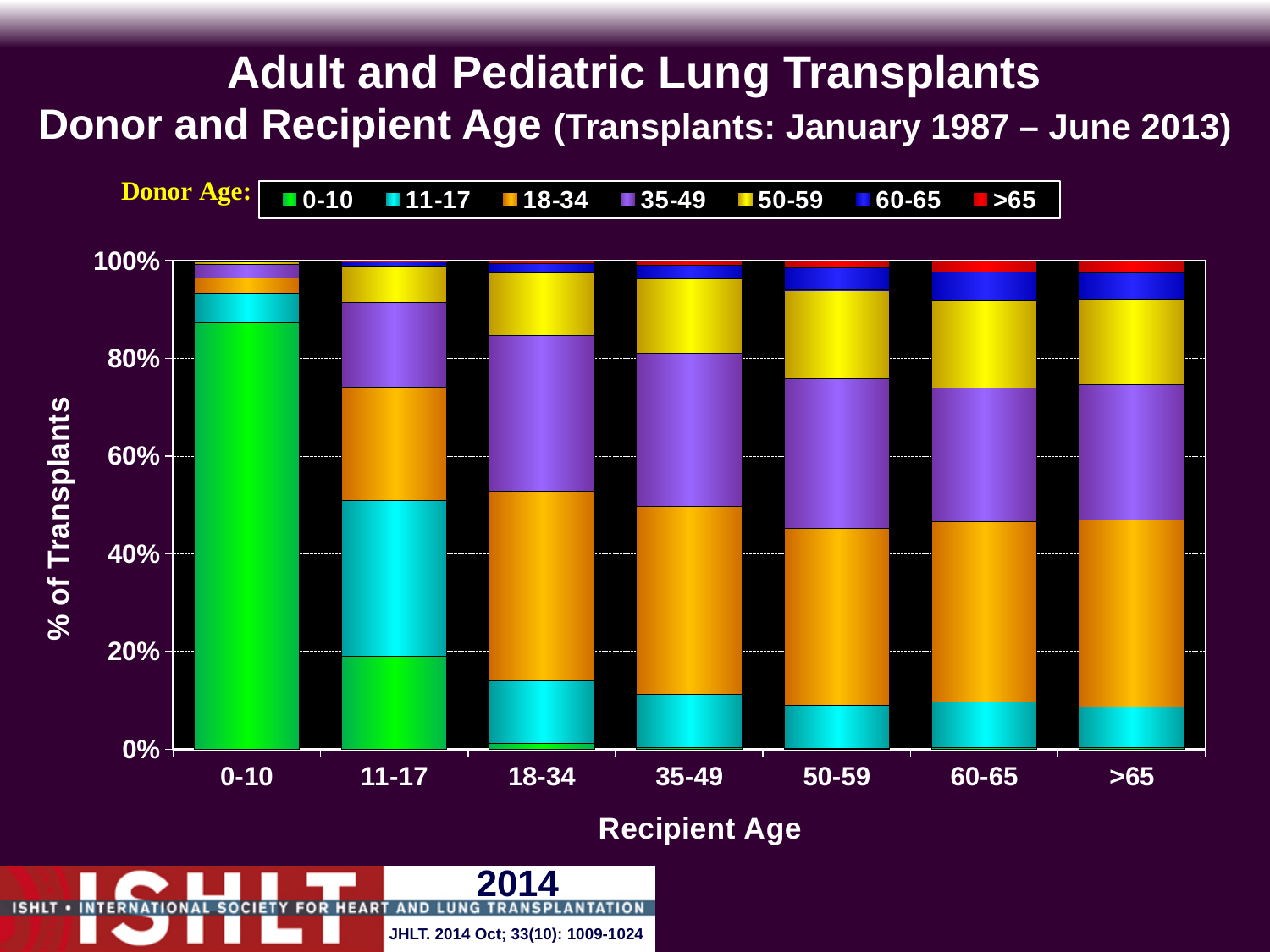
How many recipient age categories are shown on the x axis? 7 Which recipient age group has the largest share of 11-17 donors? 11-17 Does the share of 0-10 donors rise or fall as recipient age increases along the x axis? fall For recipients aged 11-17, which is larger: the share of 0-10 donors or the share of 11-17 donors? 11-17 donors Is the share of 0-10 donors for recipients aged 0-10 greater or less than 80%? greater What kind of chart is shown on the slide? Stacked bar chart Which recipient age group has the largest share of 0-10 donors? 0-10 Is the combined share of donors aged 34 or younger for recipients aged 18-34 greater or less than 40%? greater How many donor age groups does the legend list? 7 Is the combined share of 0-10 and 11-17 donors for recipients aged 11-17 greater or less than 40%? greater What is the label of the y axis? % of Transplants What is the label of the x axis? Recipient Age